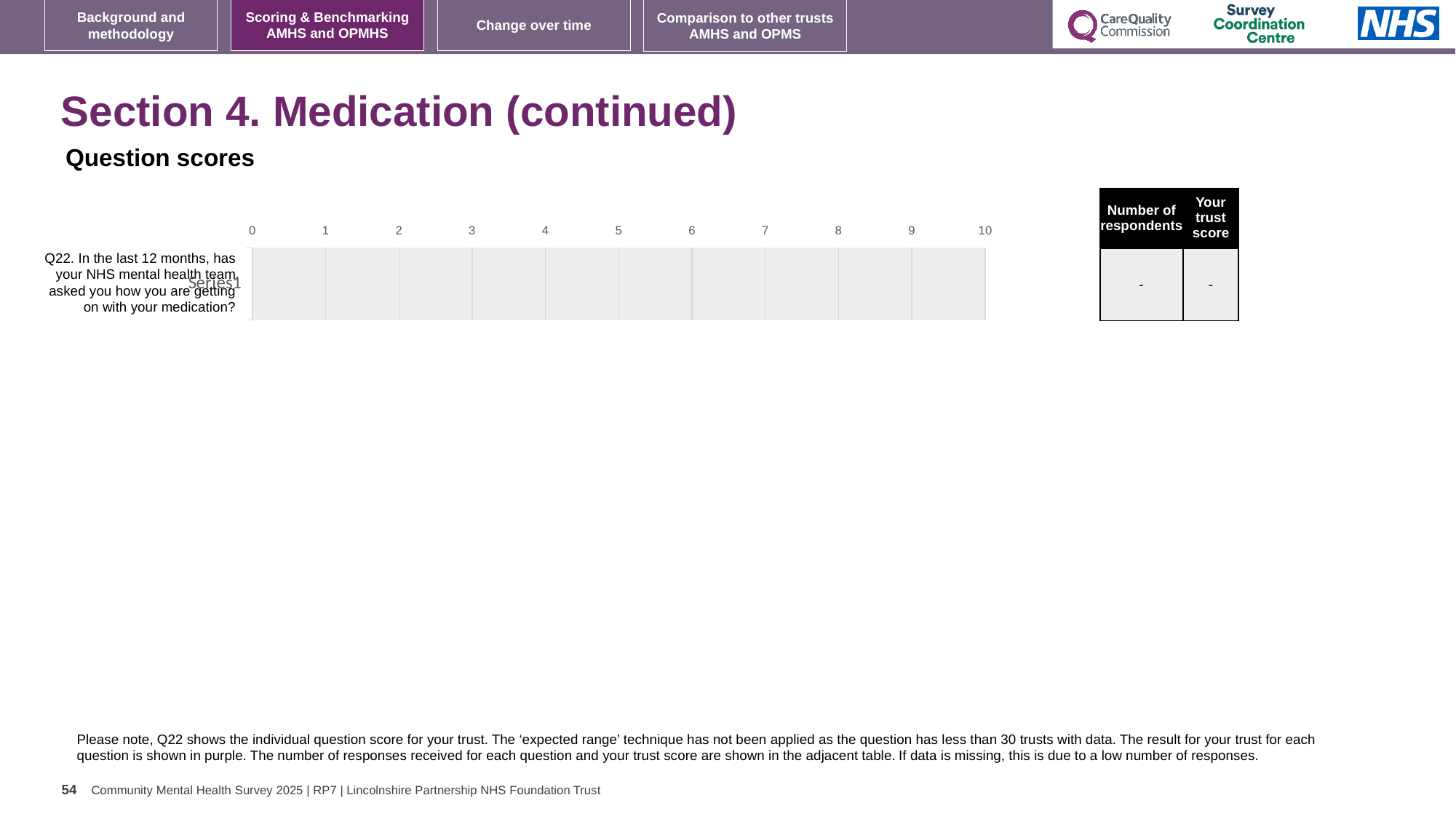
Which question number is shown on the chart? Q22 How many questions (categories) are listed on the chart's vertical axis? 1 What is the highest value shown on the chart's horizontal axis? 10 What is shown in the 'Your trust score' column of the table next to the chart for Q22? - What is shown in the 'Number of respondents' column of the table next to the chart for Q22? - What kind of chart is shown under 'Question scores'? bar chart